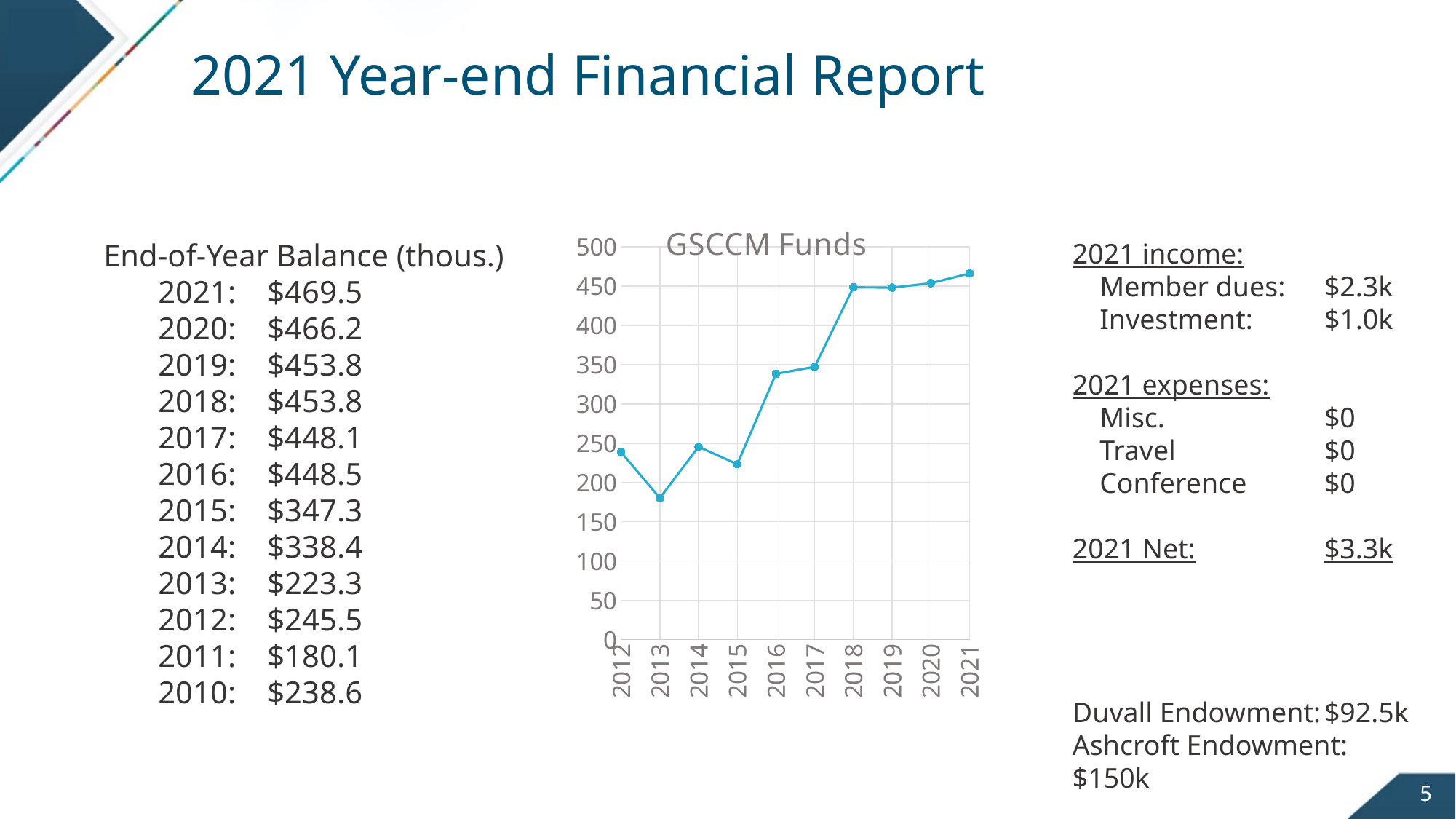
How many years are plotted on the x axis of the GSCCM Funds chart? 10 What is the title of the chart on the slide? GSCCM Funds In the GSCCM Funds chart, which year has the lowest value? 2013 Overall, do the values in the GSCCM Funds chart rise or fall from 2012 to 2021? rise In the GSCCM Funds chart, which is larger, the value for 2016 or the value for 2013? 2016 In the GSCCM Funds chart, is the value for 2016 greater or less than 300? greater In the GSCCM Funds chart, is the value for 2021 greater or less than 450? greater In the GSCCM Funds chart, which year has the highest value? 2021 In the GSCCM Funds chart, is the value for 2018 greater or less than 400? greater In the GSCCM Funds chart, which is larger, the value for 2018 or the value for 2017? 2018 What kind of chart is the GSCCM Funds chart? line chart